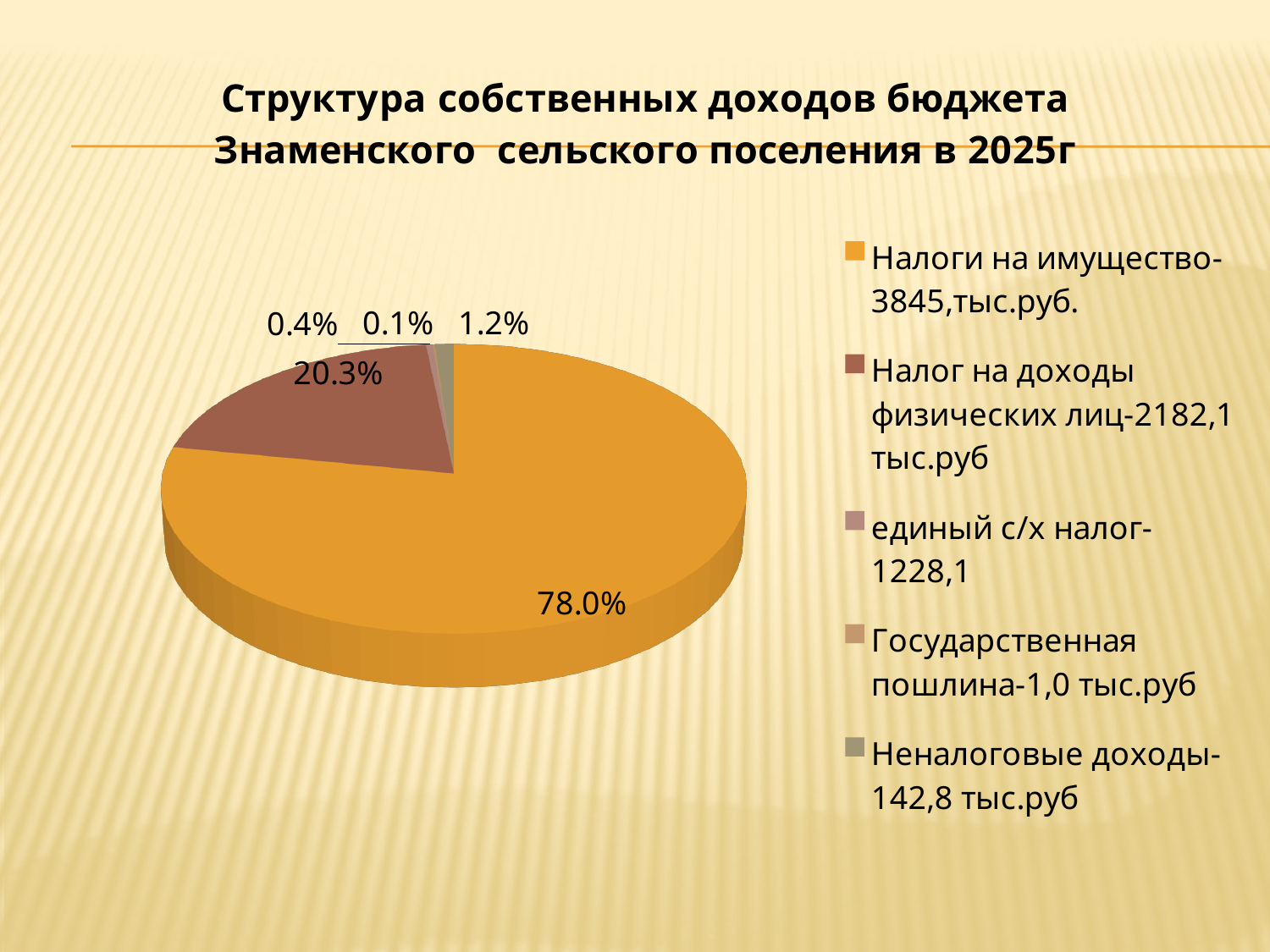
What amount does the legend give for Государственная пошлина? 1,0 тыс.руб Which category has the largest slice of the pie? Налоги на имущество What amount in thousand rubles does the legend give for Неналоговые доходы? 142,8 тыс.руб How many categories does the legend list? 5 What is the smallest percentage label shown on the pie? 0.1% Which slice is larger: Налоги на имущество or Налог на доходы физических лиц? Налоги на имущество What share of the pie is labelled for Налоги на имущество? 78.0% What type of chart is shown on the slide? pie chart What is the largest percentage label shown on the pie? 78.0% What share of the pie is labelled for Налог на доходы физических лиц? 20.3% By how many percentage points does the Налоги на имущество slice exceed the Налог на доходы физических лиц slice? 57.7